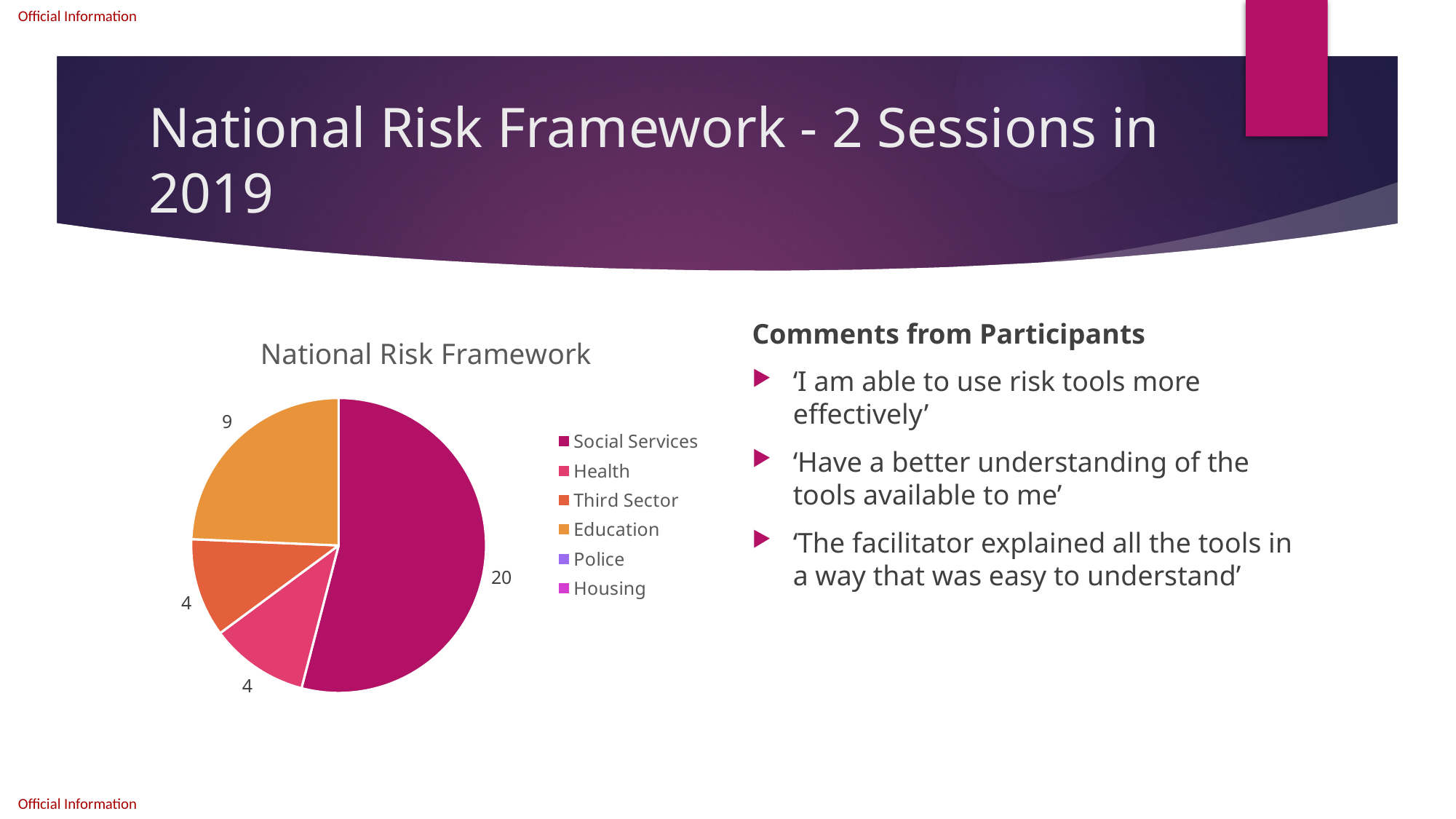
What is the difference between the values for Social Services and Education? 11 What is the value for Social Services in the National Risk Framework pie chart? 20 What is the value for Third Sector in the pie chart? 4 Which is larger, the value for Education or the value for Health? Education What is the difference between the values for Education and Third Sector? 5 Which category has the largest slice in the pie chart? Social Services What is the value for Education in the pie chart? 9 What kind of chart is shown on the slide? pie chart How many slices in the pie chart have a data label printed next to them? 4 What is the title of the pie chart? National Risk Framework What is the value for Health in the pie chart? 4 How many categories does the legend of the pie chart list? 6